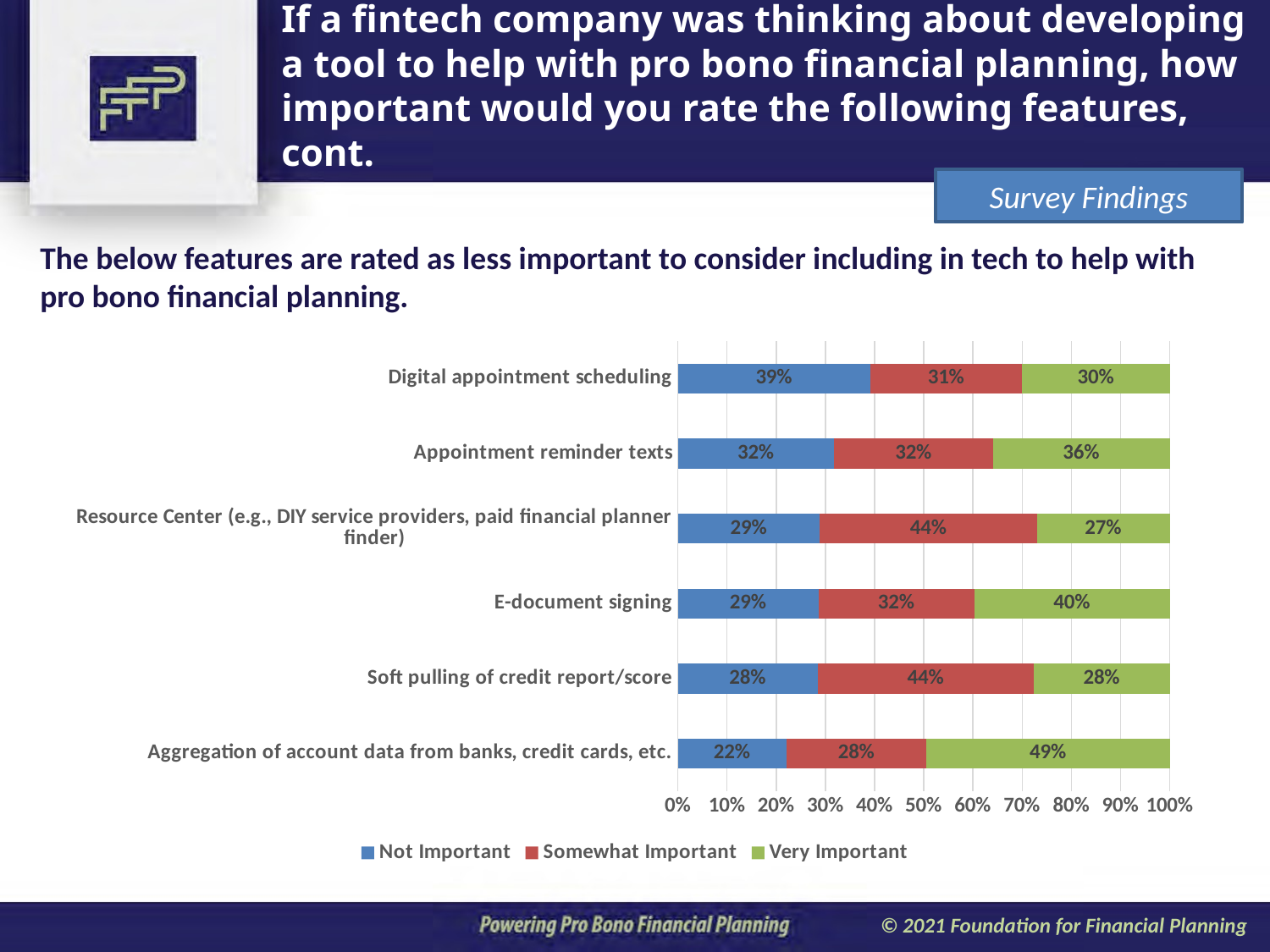
How many features are shown in the chart? 6 What percentage rated E-document signing as Very Important? 40% What percentage rated Soft pulling of credit report/score as Somewhat Important? 44% What percentage rated Digital appointment scheduling as Not Important? 39% Which feature has the lowest Not Important percentage? Aggregation of account data from banks, credit cards, etc. What is the difference between the Very Important percentages for Aggregation of account data from banks, credit cards, etc. and Digital appointment scheduling? 19% How many series does the legend list? 3 Which colour represents Very Important in the chart? Green What percentage rated Aggregation of account data from banks, credit cards, etc. as Very Important? 49% Which feature has the highest Very Important percentage? Aggregation of account data from banks, credit cards, etc. Which is larger: the Somewhat Important percentage for Resource Center (e.g., DIY service providers, paid financial planner finder) or for Appointment reminder texts? Resource Center (e.g., DIY service providers, paid financial planner finder) What kind of chart is shown on the slide? Stacked bar chart